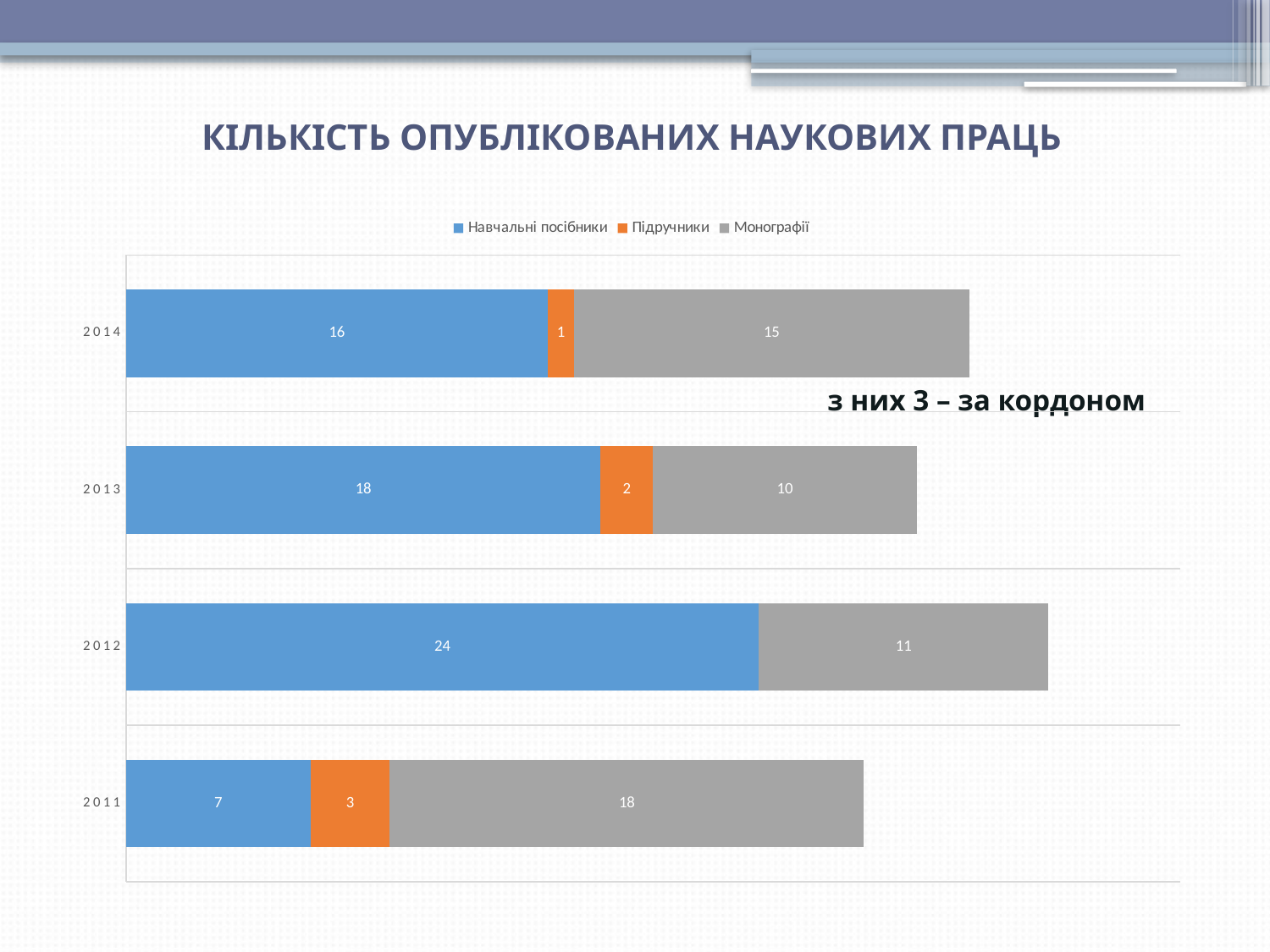
What is the value for Навчальні посібники in 2012? 24 What is the title of the chart? КІЛЬКІСТЬ ОПУБЛІКОВАНИХ НАУКОВИХ ПРАЦЬ How many series does the legend list? 3 Which year has the highest value for Навчальні посібники? 2012 What type of chart is shown on the slide? Stacked bar chart What is the total of the stacked bar for 2014? 32 What is the difference between Монографії in 2014 and Монографії in 2013? 5 How many years (categories) are shown on the chart? 4 What is the value for Монографії in 2011? 18 What is the value for Підручники in 2013? 2 Which year has the lowest value for Монографії? 2013 Which is larger: Навчальні посібники in 2014 or Монографії in 2014? Навчальні посібники in 2014